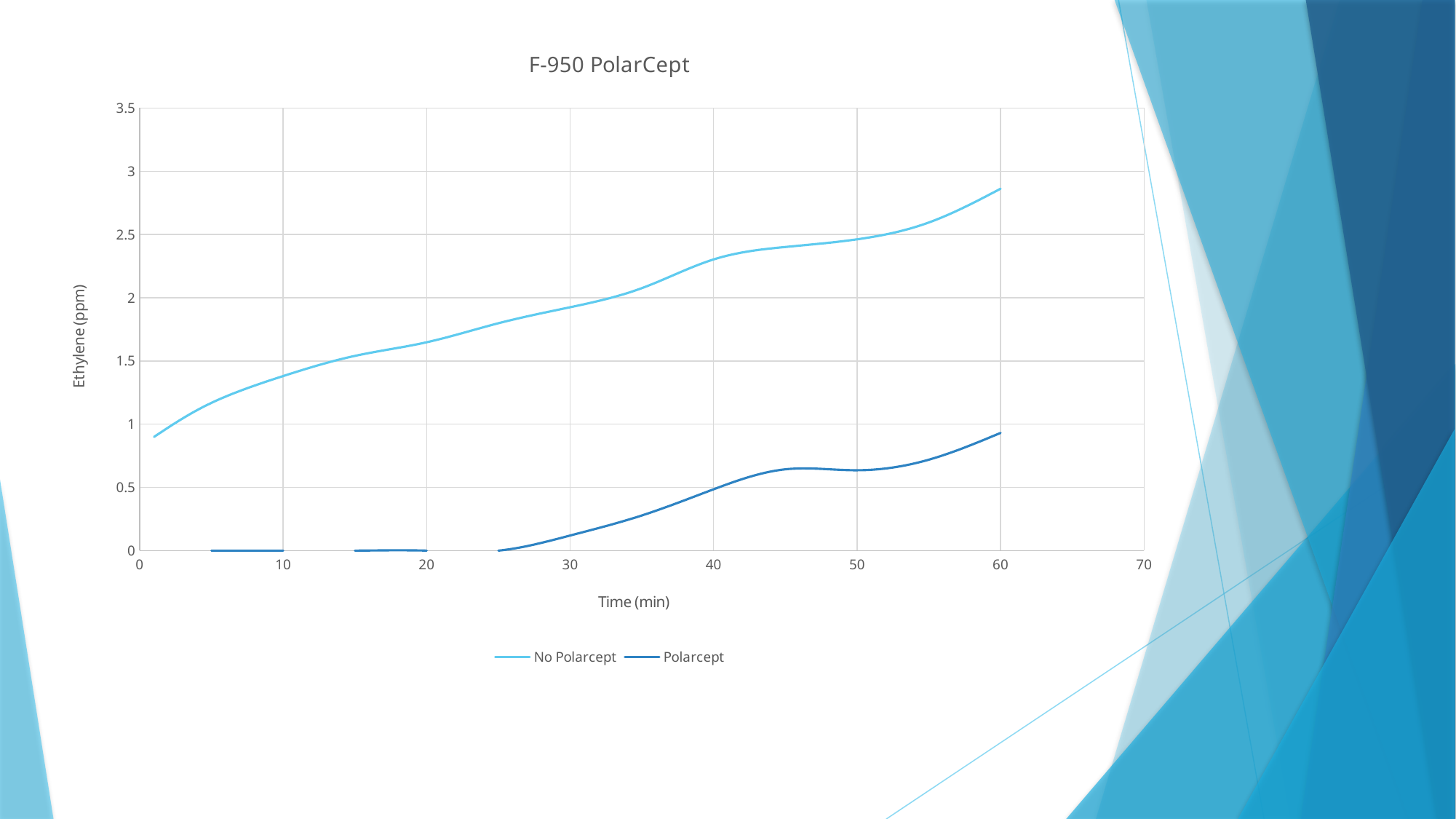
Does the No Polarcept series rise or fall as time increases from 0 to 60 min? rise Is the value for No Polarcept at 60 min greater or less than 2.5? greater Is the value for No Polarcept at 10 min greater or less than 1.5? less What kind of chart is shown on the slide? line chart What is the value for Polarcept at 5 min? 0 Is the value for Polarcept at 60 min greater or less than 1? less At 60 min, which series has the higher value, No Polarcept or Polarcept? No Polarcept How many series does the legend list? 2 What is the label of the y axis? Ethylene (ppm) What is the title of the chart? F-950 PolarCept